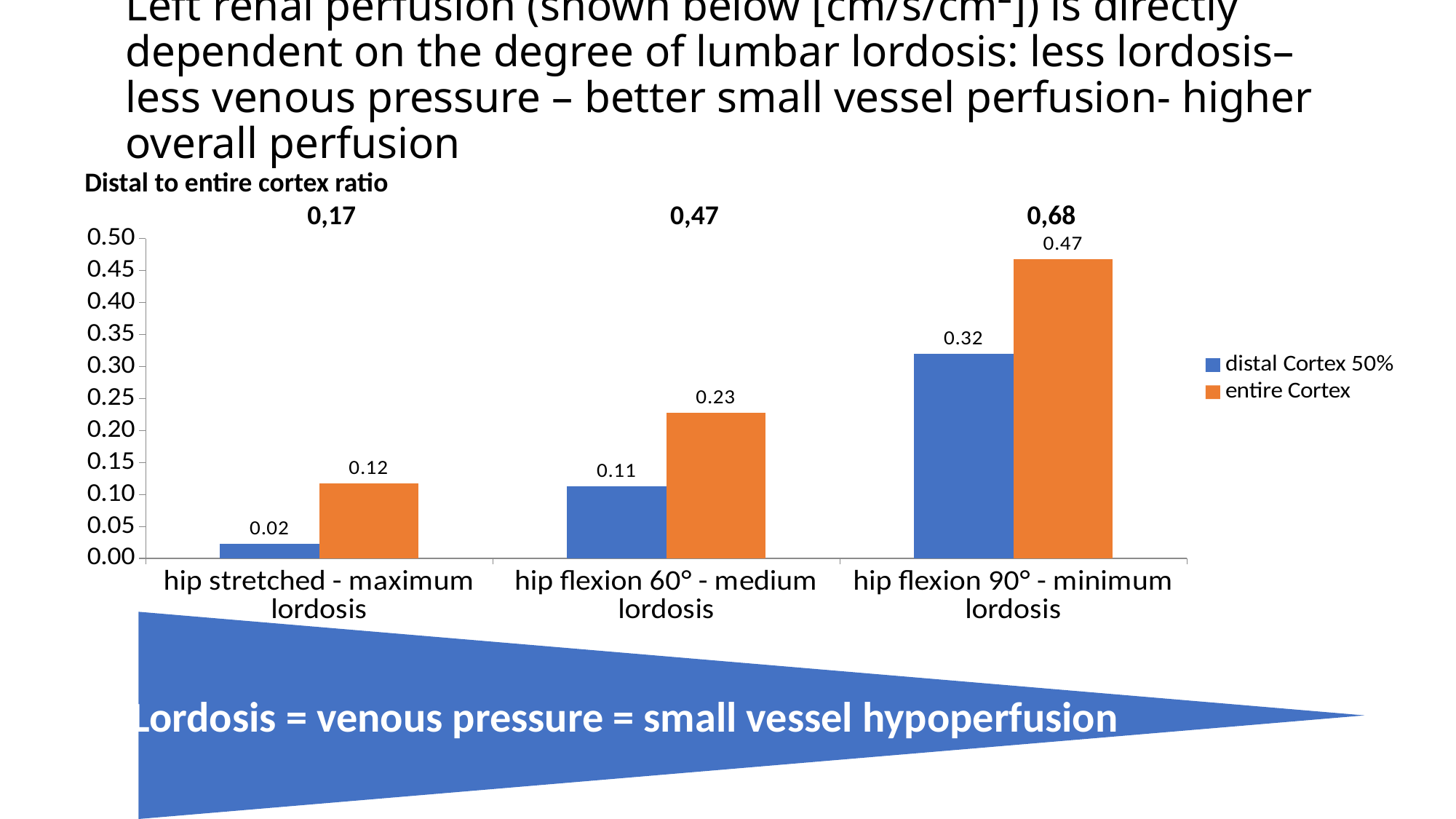
How many series does the legend list? 2 What is the value for entire Cortex at hip flexion 60° - medium lordosis? 0.23 Which category has the highest value for distal Cortex 50%? hip flexion 90° - minimum lordosis Which is larger at hip flexion 60° - medium lordosis: distal Cortex 50% or entire Cortex? entire Cortex Which category has the lowest value for entire Cortex? hip stretched - maximum lordosis What is the difference between the entire Cortex and distal Cortex 50% values at hip flexion 90° - minimum lordosis? 0.15 Do the entire Cortex values rise or fall from left to right along the x axis? rise What is the value for distal Cortex 50% at hip stretched - maximum lordosis? 0.02 What kind of chart is shown on the slide? bar chart What distal to entire cortex ratio is printed above the hip flexion 60° - medium lordosis bars? 0,47 How many categories are shown on the x axis? 3 What is the value for entire Cortex at hip flexion 90° - minimum lordosis? 0.47